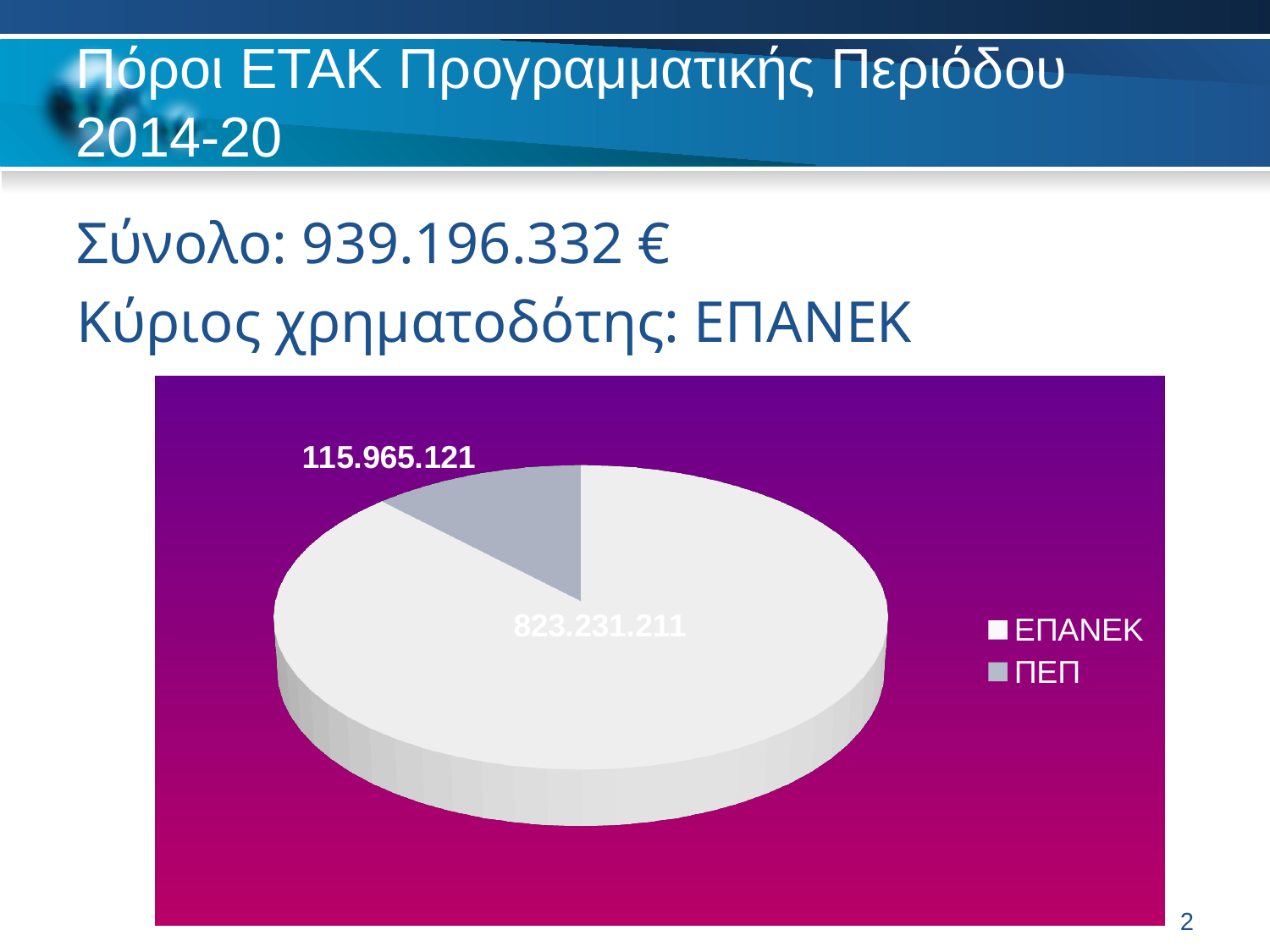
What is the difference between the value for ΕΠΑΝΕΚ and the value for ΠΕΠ? 707.266.090 Which category has the largest slice in the pie chart? ΕΠΑΝΕΚ How many slices does the pie chart have? 2 Which category has the smallest slice in the pie chart? ΠΕΠ What is the total of the two slices in the pie chart? 939.196.332 What share of the pie does the ΠΕΠ slice represent, to one decimal place? 12.3% Which is larger, the value for ΕΠΑΝΕΚ or the value for ΠΕΠ? ΕΠΑΝΕΚ What is the value shown for ΠΕΠ in the pie chart? 115.965.121 Which two categories are listed in the legend of the pie chart? ΕΠΑΝΕΚ and ΠΕΠ How many entries does the legend of the pie chart list? 2 What is the value shown for ΕΠΑΝΕΚ in the pie chart? 823.231.211 What kind of chart is shown on the slide? pie chart